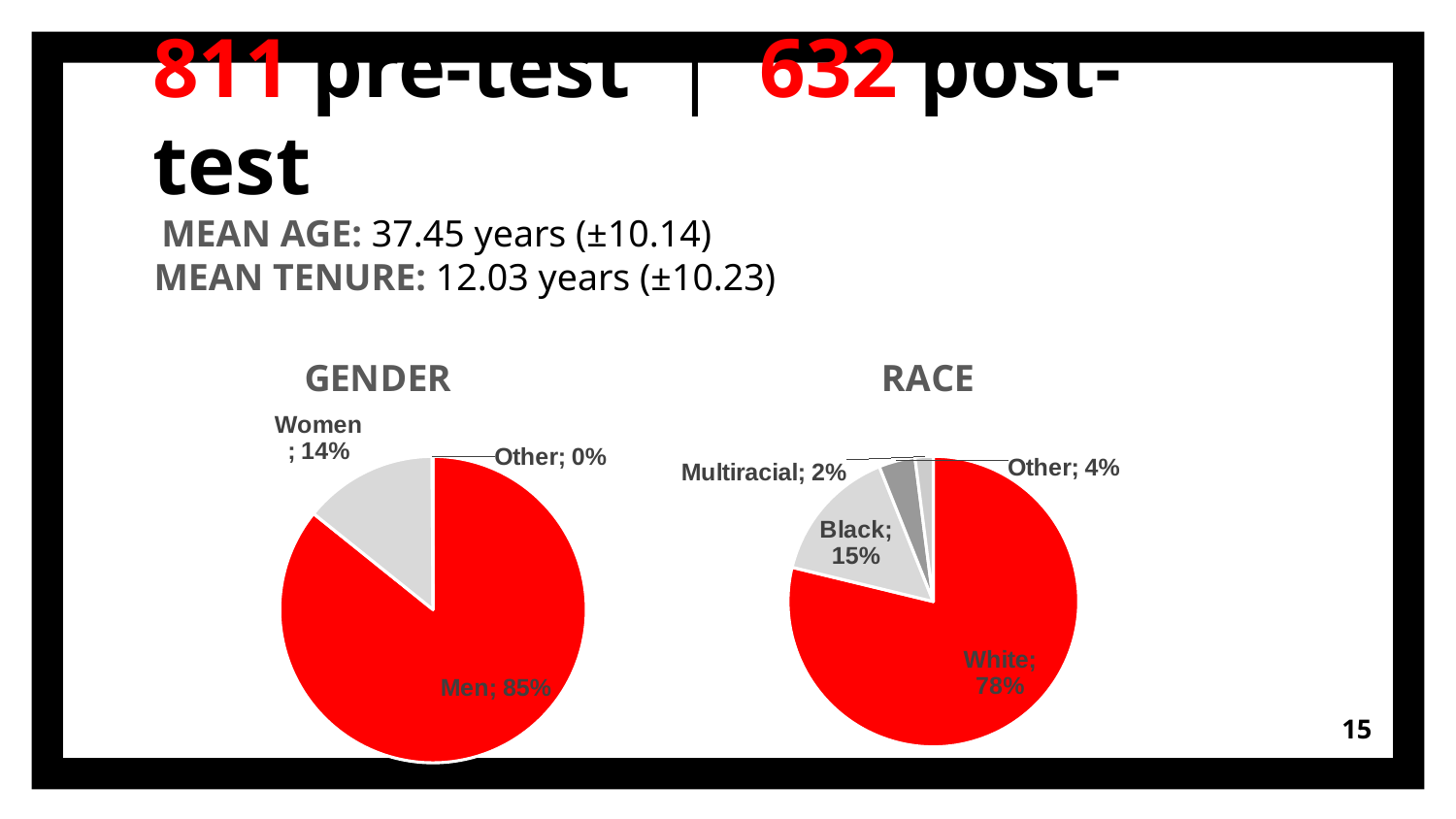
In the GENDER pie chart, what percentage is shown for Other? 0% In the RACE pie chart, what percentage is shown for Multiracial? 2% In the RACE pie chart, what percentage is shown for Other? 4% In the GENDER pie chart, what percentage is shown for Women? 14% What type of chart is used for the GENDER and RACE data? Pie chart In the GENDER pie chart, what is the difference in percentage points between Men and Women? 71 In the RACE pie chart, what percentage is shown for White? 78% In the RACE pie chart, which is larger, the share for Black or the share for Other? Black In the RACE pie chart, what percentage is shown for Black? 15% In the RACE pie chart, which category has the largest share? White In the GENDER pie chart, what percentage is shown for Men? 85% In the RACE pie chart, which category has the smallest share? Multiracial